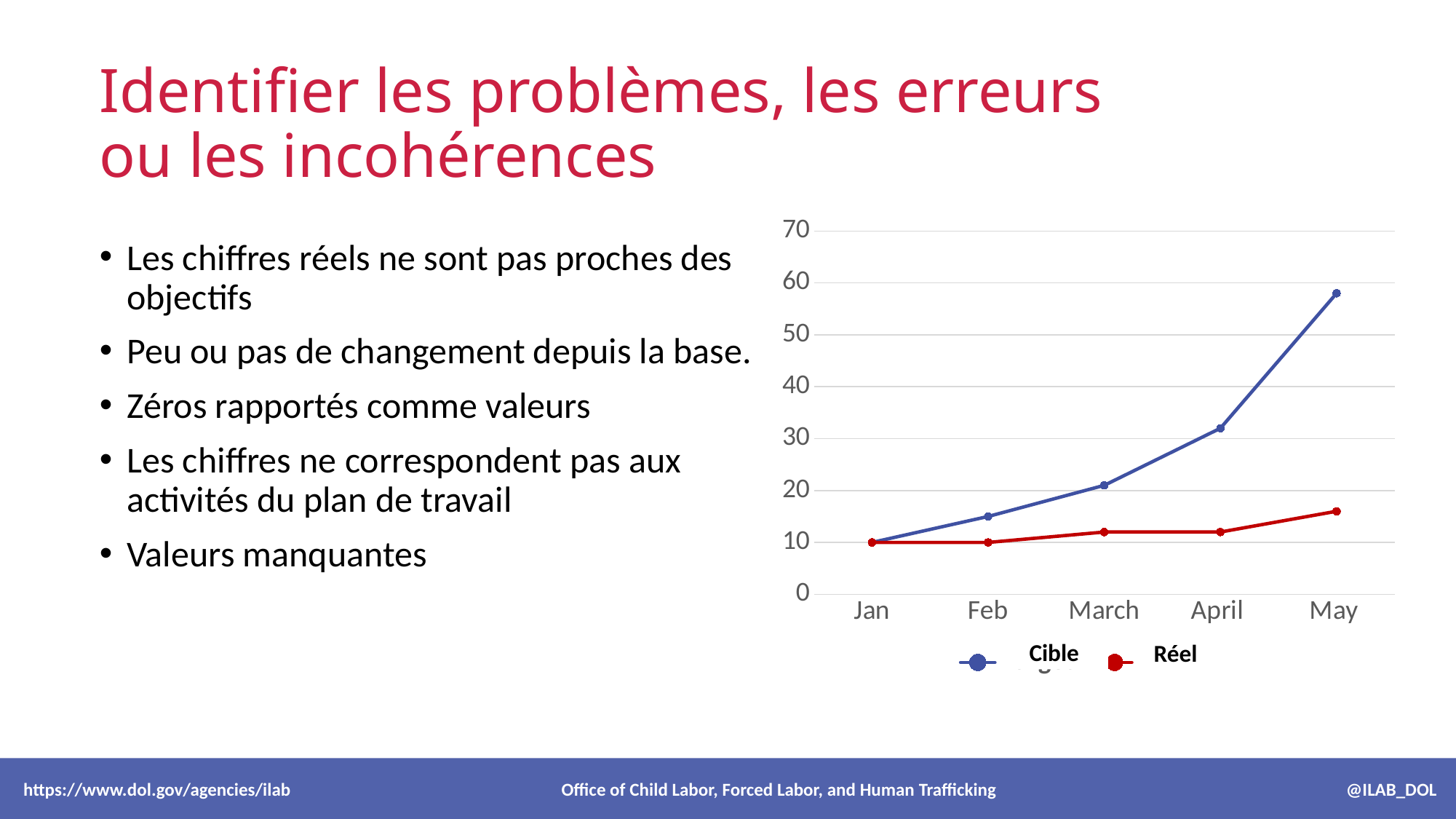
What is the value of the Cible series in Jan? 10 In which month does the Cible series reach its highest value? May Is the value for Réel in May greater or less than 20? less What kind of chart is shown on the slide? line chart Does the Cible series rise or fall from Jan to May? rise What is the value of the Réel series in Feb? 10 Is the value for Cible in May greater or less than 50? greater How many months are shown on the x axis of the chart? 5 How many series does the chart legend list? 2 In which month does the Réel series reach its highest value? May In May, which series has the larger value, Cible or Réel? Cible